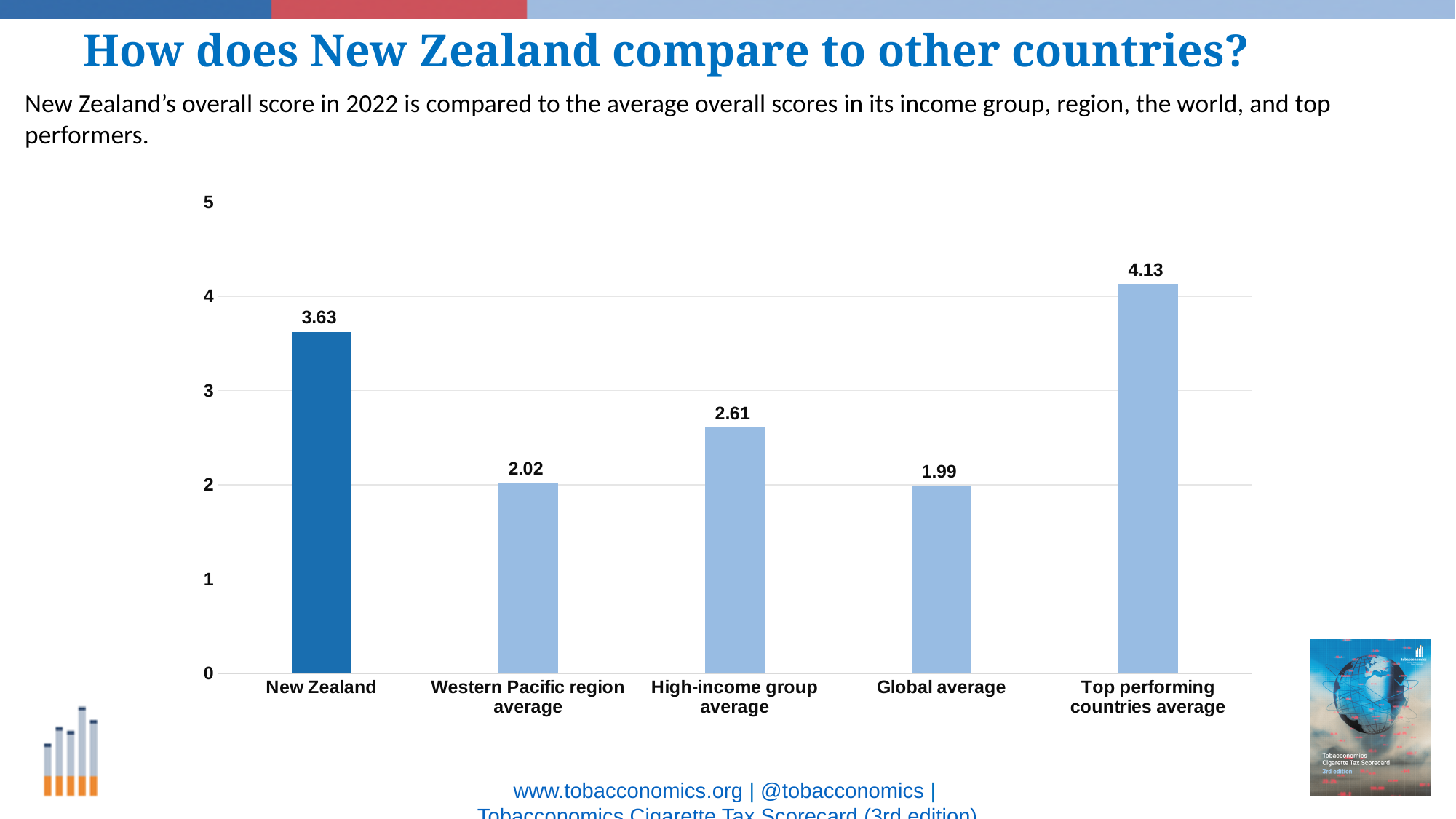
What is the value for the Western Pacific region average? 2.02 Which category has the lowest value? Global average What is the value for New Zealand? 3.63 What is the difference between the Top performing countries average and New Zealand? 0.50 What is the value for the Global average? 1.99 How many categories are shown on the chart? 5 What is the value for the Top performing countries average? 4.13 What is the value for the High-income group average? 2.61 Which is larger, New Zealand or the High-income group average? New Zealand What is the difference between New Zealand and the Global average? 1.64 What kind of chart is shown on the slide? Bar chart Which category has the highest value? Top performing countries average